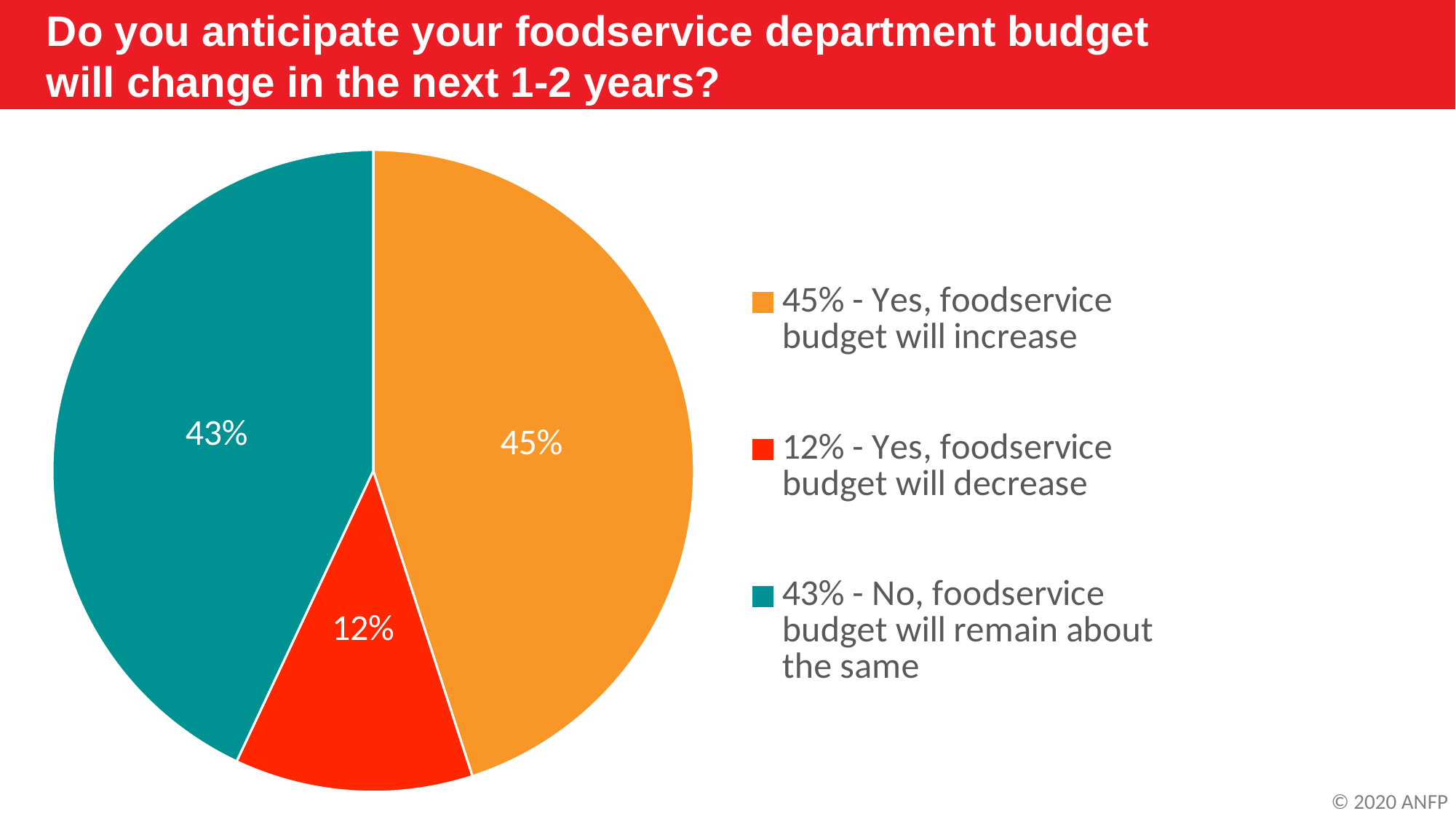
Which response has the smallest share of the pie? Yes, foodservice budget will decrease Which is larger: the share for 'budget will remain about the same' or the share for 'budget will decrease'? budget will remain about the same What share of respondents said their foodservice budget will remain about the same? 43% What is the difference in percentage points between the 'budget will increase' and 'budget will decrease' slices? 33 What kind of chart is shown on the slide? pie chart What colour is the slice for 'Yes, foodservice budget will decrease'? red What is the difference in percentage points between the 'budget will increase' and 'budget will remain about the same' slices? 2 Which response has the largest share of the pie? Yes, foodservice budget will increase How many slices does the pie chart have? 3 What share of respondents said their foodservice budget will increase? 45% What share of respondents said their foodservice budget will decrease? 12% What question does the slide title ask? Do you anticipate your foodservice department budget will change in the next 1-2 years?